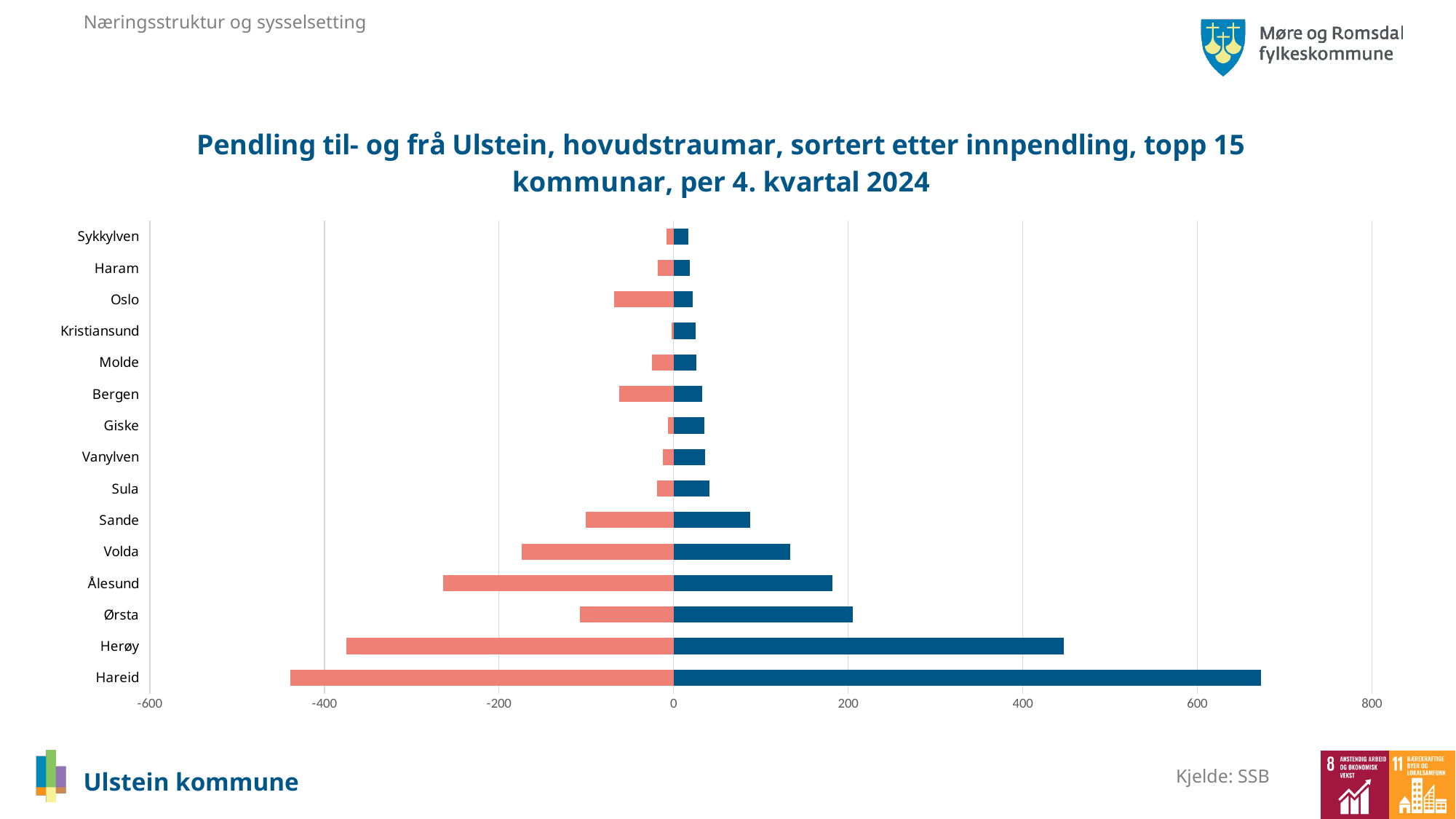
Is the blue bar value for Hareid greater or less than 600? greater How many municipalities (categories) are listed on the vertical axis of the chart? 15 Is the blue bar value for Volda greater or less than 200? less Which municipality has the longest blue (positive) bar in the chart? Hareid What kind of chart is shown on the slide? bar chart Is the blue bar value for Herøy greater or less than 400? greater Which municipality has the longest red (negative) bar in the chart? Hareid Which has the larger blue bar, Ålesund or Volda? Ålesund Which has the larger blue bar, Hareid or Herøy? Hareid What is the title of the chart? Pendling til- og frå Ulstein, hovudstraumar, sortert etter innpendling, topp 15 kommunar, per 4. kvartal 2024